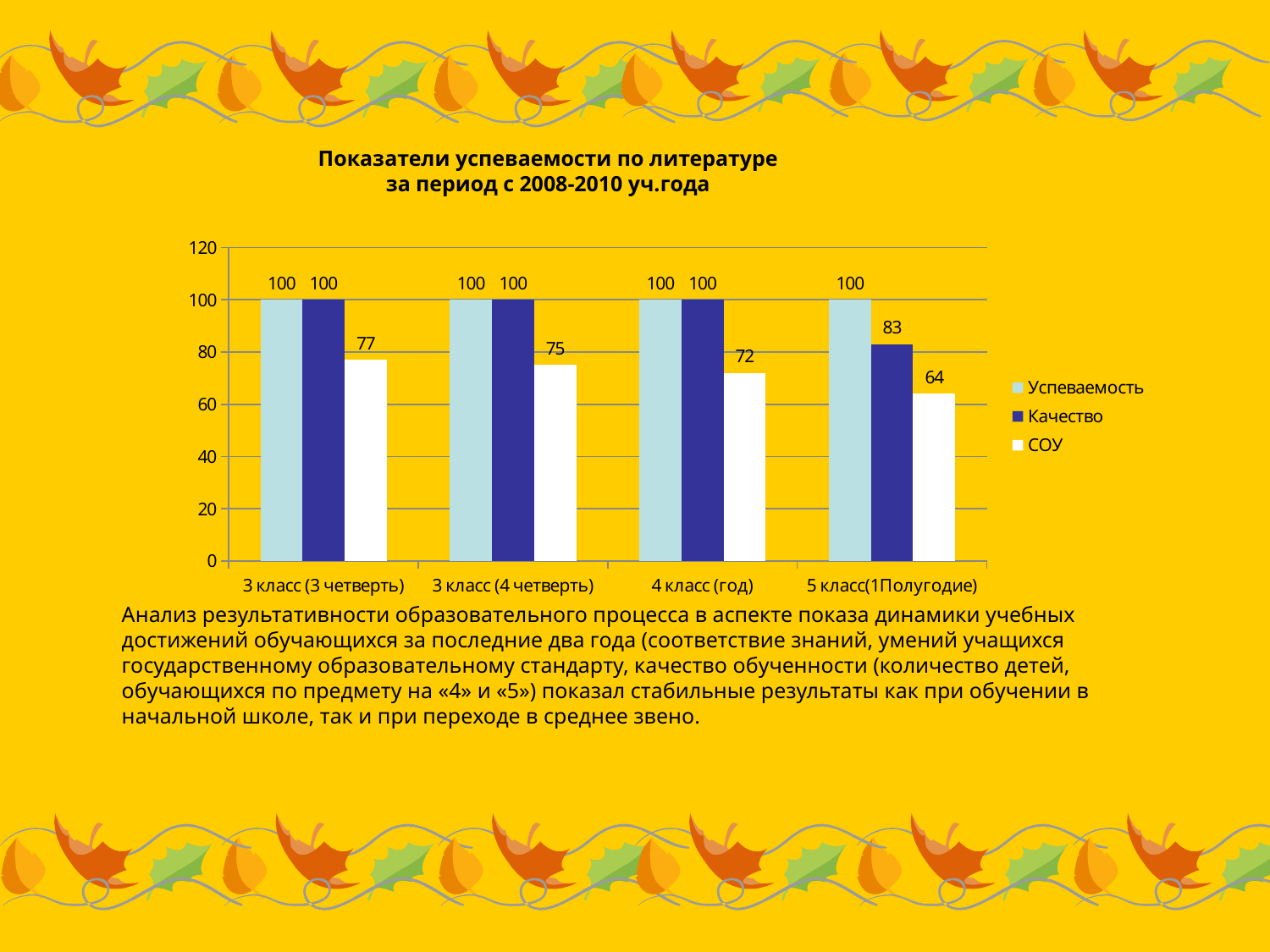
What is the difference between the СОУ values for 3 класс (3 четверть) and 5 класс(1Полугодие)? 13 What kind of chart is shown on the slide? bar chart Do the СОУ values rise or fall from left to right along the x axis? fall How many series does the legend list? 3 What is the СОУ value for 3 класс (3 четверть)? 77 What is the difference between the Успеваемость and Качество values for 5 класс(1Полугодие)? 17 How many categories are shown on the x axis? 4 Which is larger, the СОУ value for 3 класс (4 четверть) or for 4 класс (год)? 3 класс (4 четверть) What is the Качество value for 5 класс(1Полугодие)? 83 Which category has the highest СОУ value? 3 класс (3 четверть) Which category has the lowest СОУ value? 5 класс(1Полугодие) What is the СОУ value for 4 класс (год)? 72